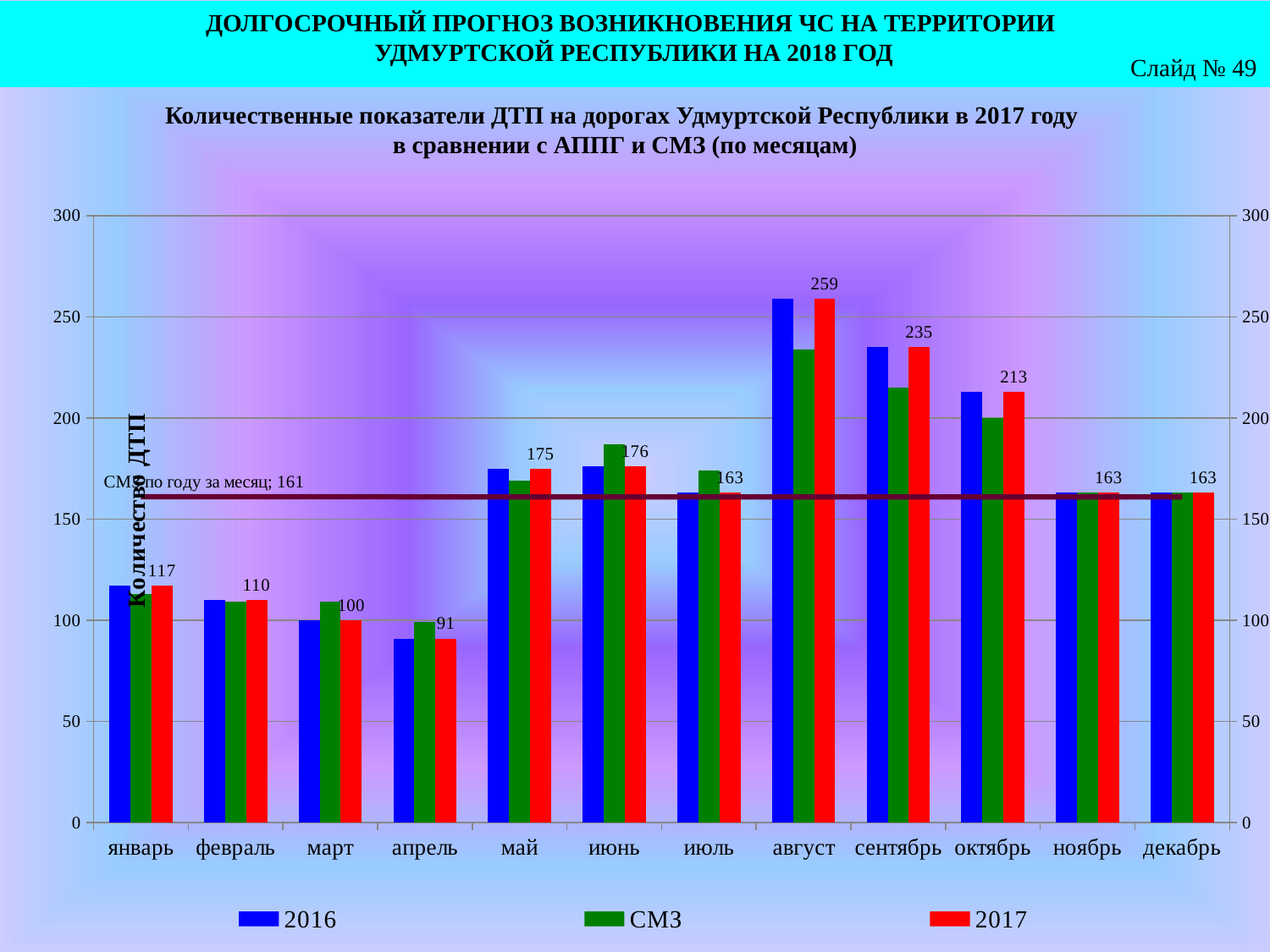
Is the value for СМЗ in август greater or less than 200? greater Which month has the lowest value for 2017? апрель What is the value for 2017 in август? 259 Which is larger, the 2017 value for сентябрь or for октябрь? сентябрь What is the value for 2017 in апрель? 91 What is the value for 2017 in октябрь? 213 What is the difference between the 2017 values for август and сентябрь? 24 Which month has the highest value for 2017? август How many months are shown on the x axis? 12 Is the value for СМЗ in июнь greater or less than 150? greater What value does the horizontal line labelled 'СМЗ по году за месяц' mark? 161 How many series does the legend list? 3